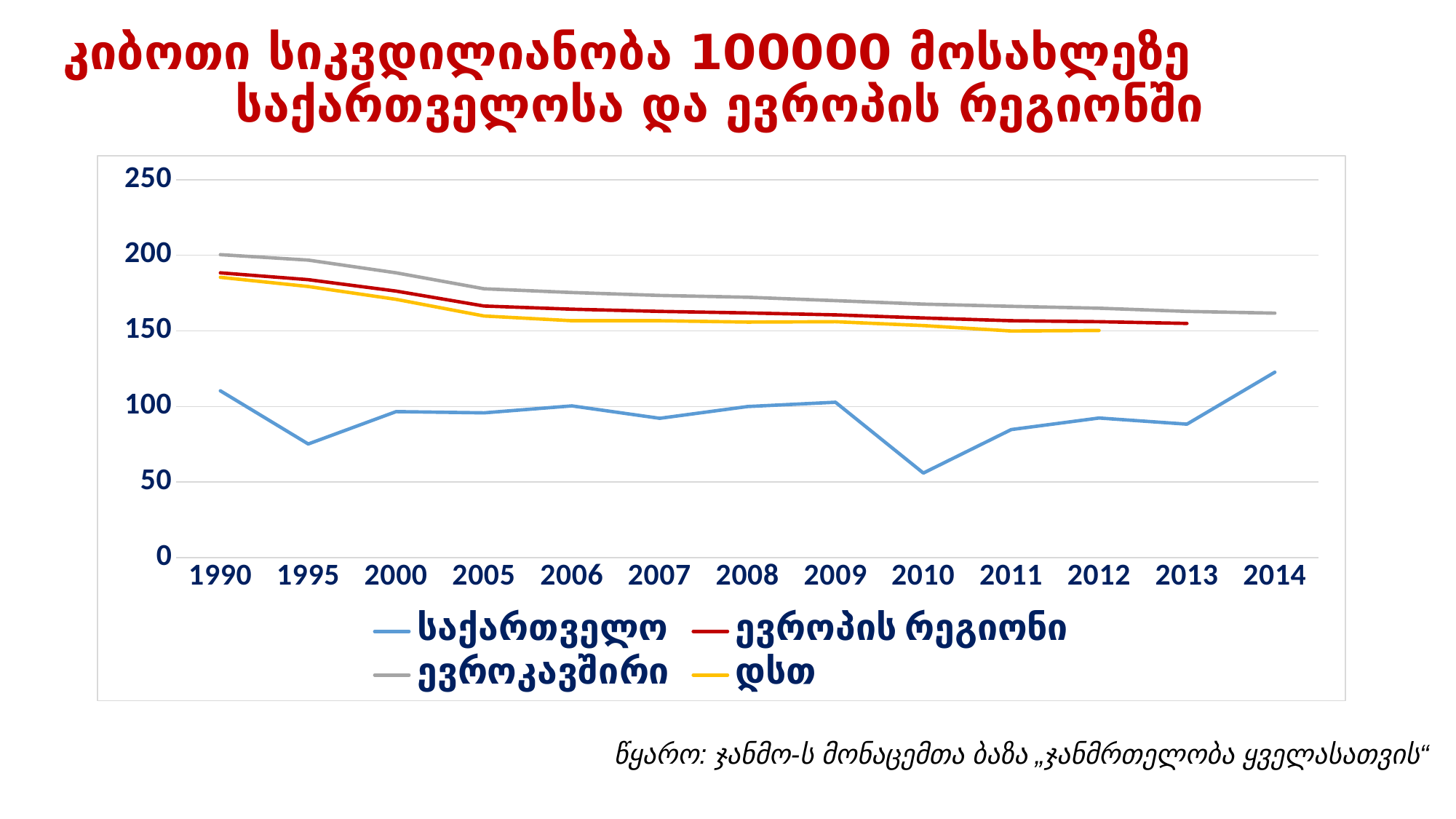
In which year is the value for საქართველო highest? 2014 What kind of chart is shown on the slide? line chart Is the value for საქართველო in 1990 greater or less than 100? greater How many years are shown along the x axis? 13 Is the value for საქართველო in 2010 greater or less than 100? less Is the value for ევროკავშირი in 1990 greater or less than 150? greater In 2014, which is larger: the value for საქართველო or the value for ევროკავშირი? ევროკავშირი How many series does the legend list? 4 In which year is the value for საქართველო lowest? 2010 Does the ევროკავშირი line rise or fall from 1990 to 2014? fall Which series has the highest value in 1990? ევროკავშირი